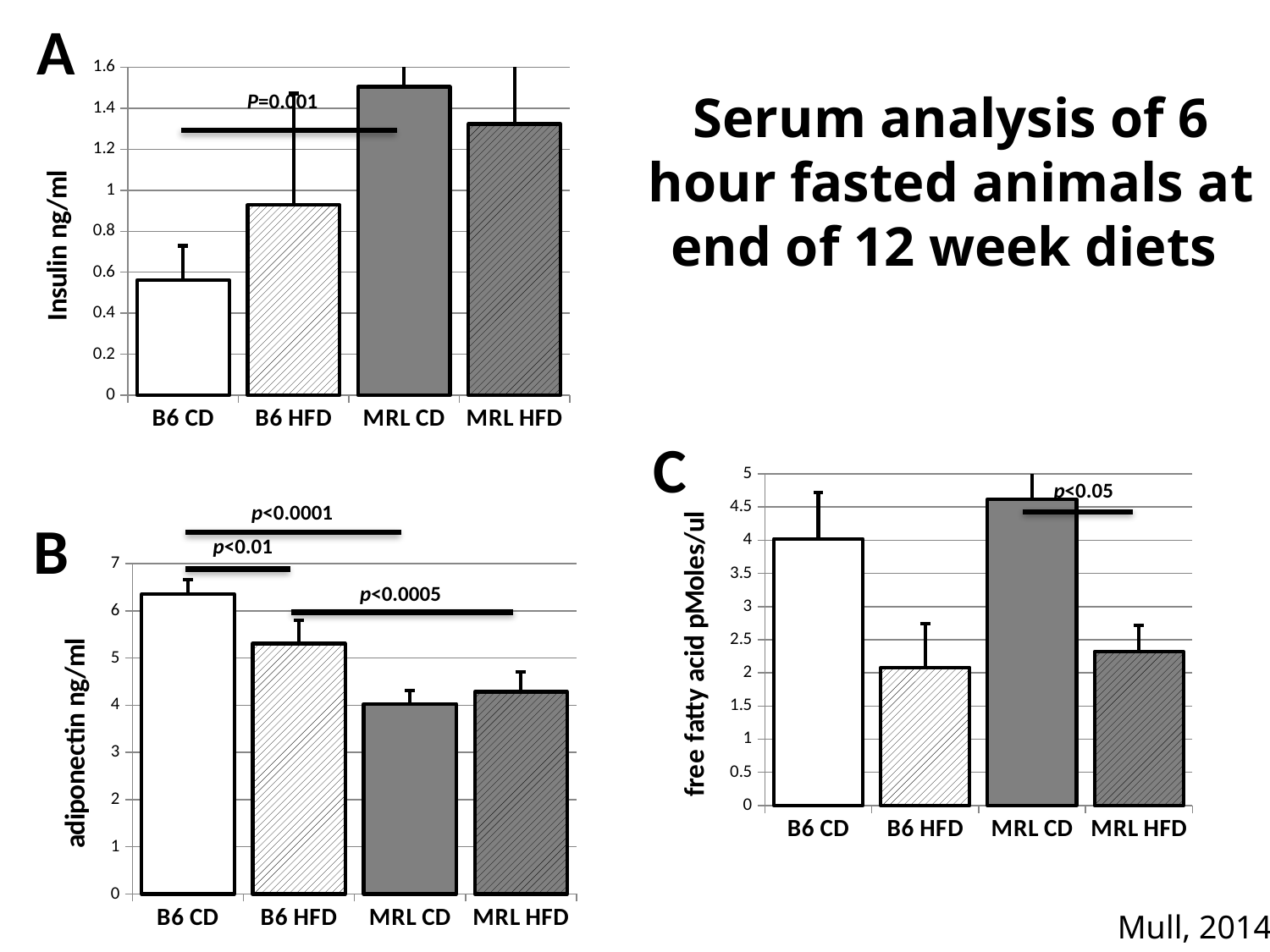
In chart C (free fatty acid pMoles/ul), is the value for MRL HFD greater or less than 3? less In chart A (Insulin ng/ml), is the value for MRL HFD greater or less than 1.2? greater In chart B (adiponectin ng/ml), which category has the highest bar? B6 CD In chart B (adiponectin ng/ml), is the value for B6 CD greater or less than 6? greater How many categories are shown on the x axis of chart C (free fatty acid pMoles/ul)? 4 In chart C (free fatty acid pMoles/ul), which category has the highest bar? MRL CD In chart B (adiponectin ng/ml), which is larger, the value for B6 HFD or the value for MRL CD? B6 HFD In chart A (Insulin ng/ml), which category has the highest bar? MRL CD In chart A (Insulin ng/ml), which category has the lowest bar? B6 CD What kind of chart is chart B (adiponectin ng/ml)? bar chart